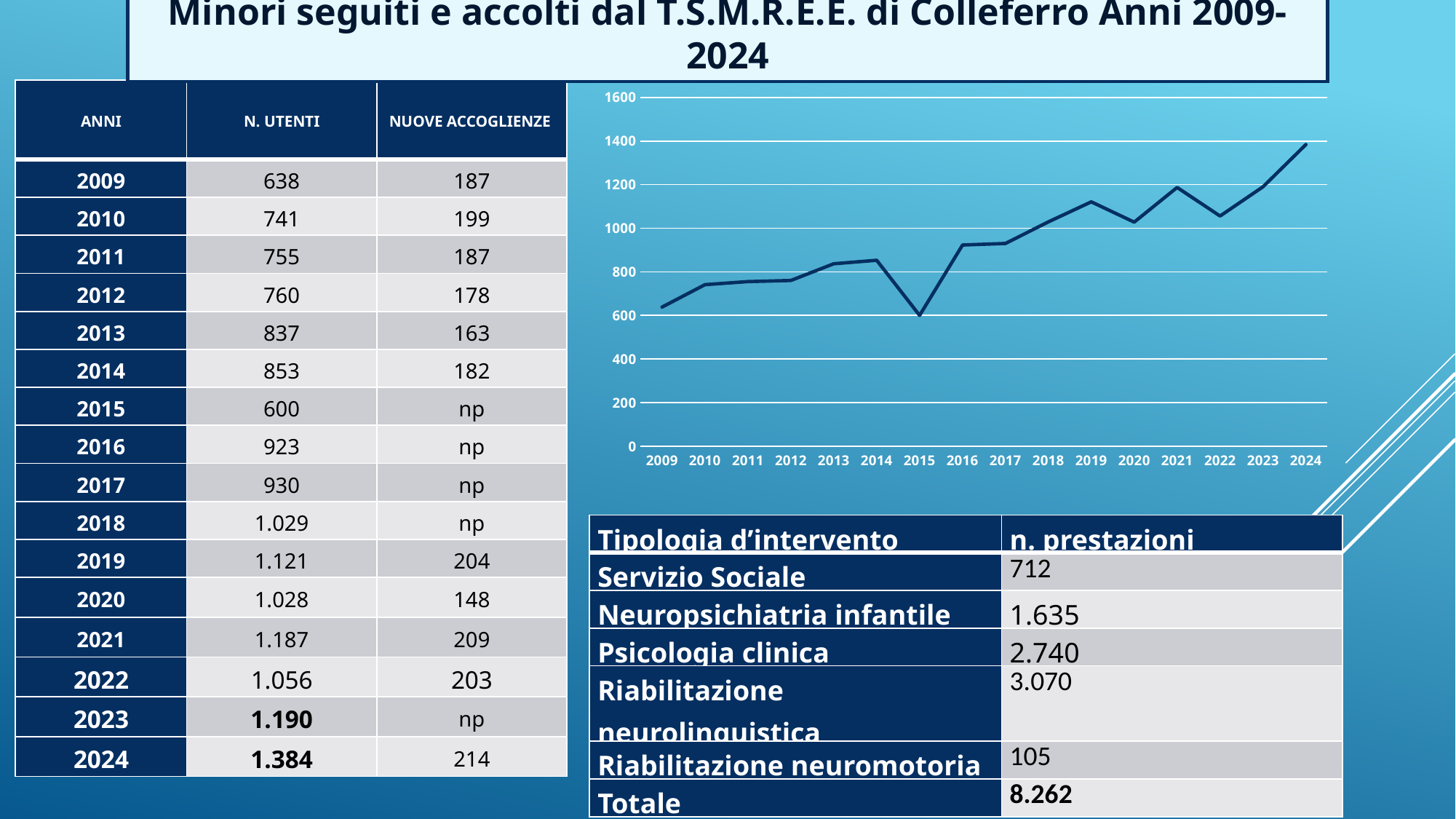
On the line chart, is the value for 2015 greater or less than 800? less On the line chart, is the value for 2009 greater or less than 800? less What kind of chart is shown on the slide? line chart On the line chart, is the value for 2021 greater or less than 1000? greater Does the line rise or fall from 2009 to 2014? rise Which year has the highest value on the line chart? 2024 How many years are plotted along the x axis of the line chart? 16 Does the line rise or fall from 2014 to 2015? fall What is the highest tick value shown on the y axis of the line chart? 1600 Which year has the lowest value on the line chart? 2015 According to the table, what is the N. UTENTI value for 2024, the last point on the line chart? 1.384